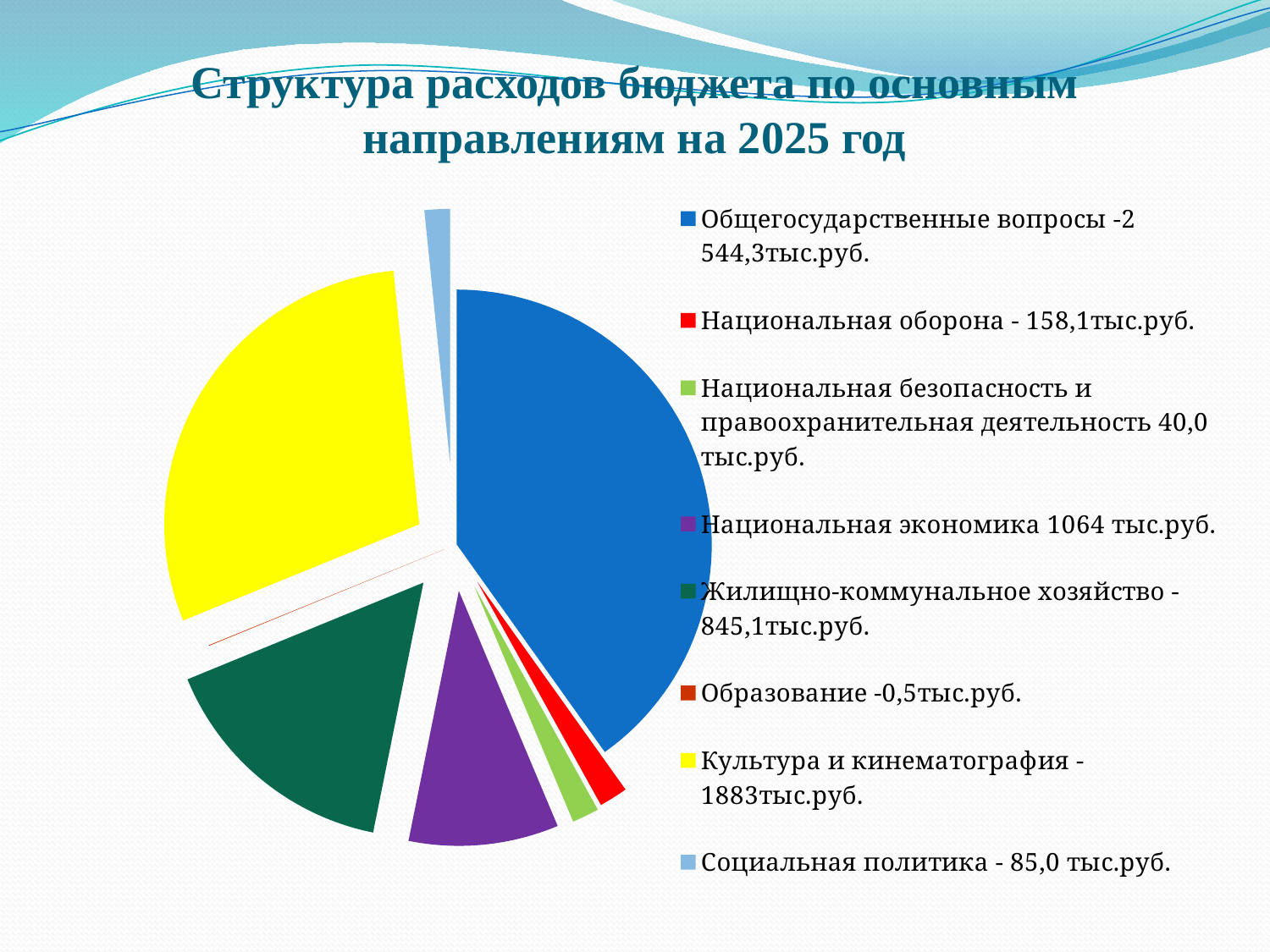
What colour is the slice for Культура и кинематография? yellow What is the value for Социальная политика? 85,0 тыс.руб. Which category has the smallest value? Образование What is the value for Национальная оборона? 158,1 тыс.руб. How many categories does the pie chart show? 8 What is the difference between Национальная оборона and Социальная политика? 73,1 тыс.руб. What is the difference between Культура и кинематография and Национальная экономика? 819 тыс.руб. Which category has the largest share of the pie? Общегосударственные вопросы What kind of chart is shown on the slide? pie chart What is the value for Общегосударственные вопросы? 2 544,3 тыс.руб. What is the value for Культура и кинематография? 1883 тыс.руб.